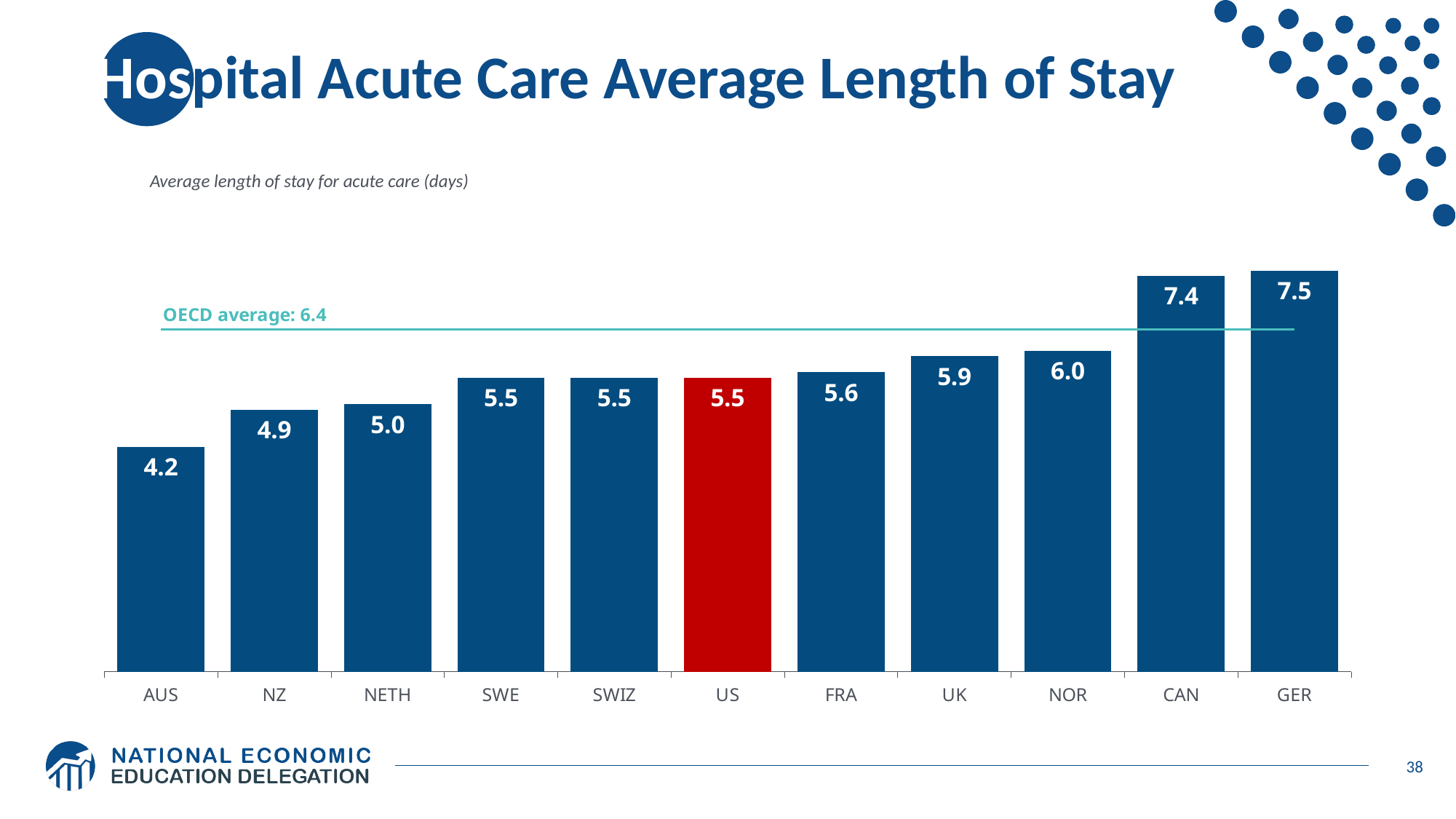
What is the average length of stay for acute care in the US? 5.5 Which country has the lowest average length of stay for acute care? AUS Which country has the highest average length of stay for acute care? GER What is the average length of stay for acute care in Germany (GER)? 7.5 Which country's bar is coloured red? US Which has a higher average length of stay, UK or NZ? UK What is the OECD average shown on the chart? 6.4 How many countries are shown on the chart? 11 What is the difference between the values for CAN and AUS? 3.2 What is the difference between the values for NOR and NETH? 1.0 What is the value shown for AUS? 4.2 What kind of chart is shown on the slide? Bar chart